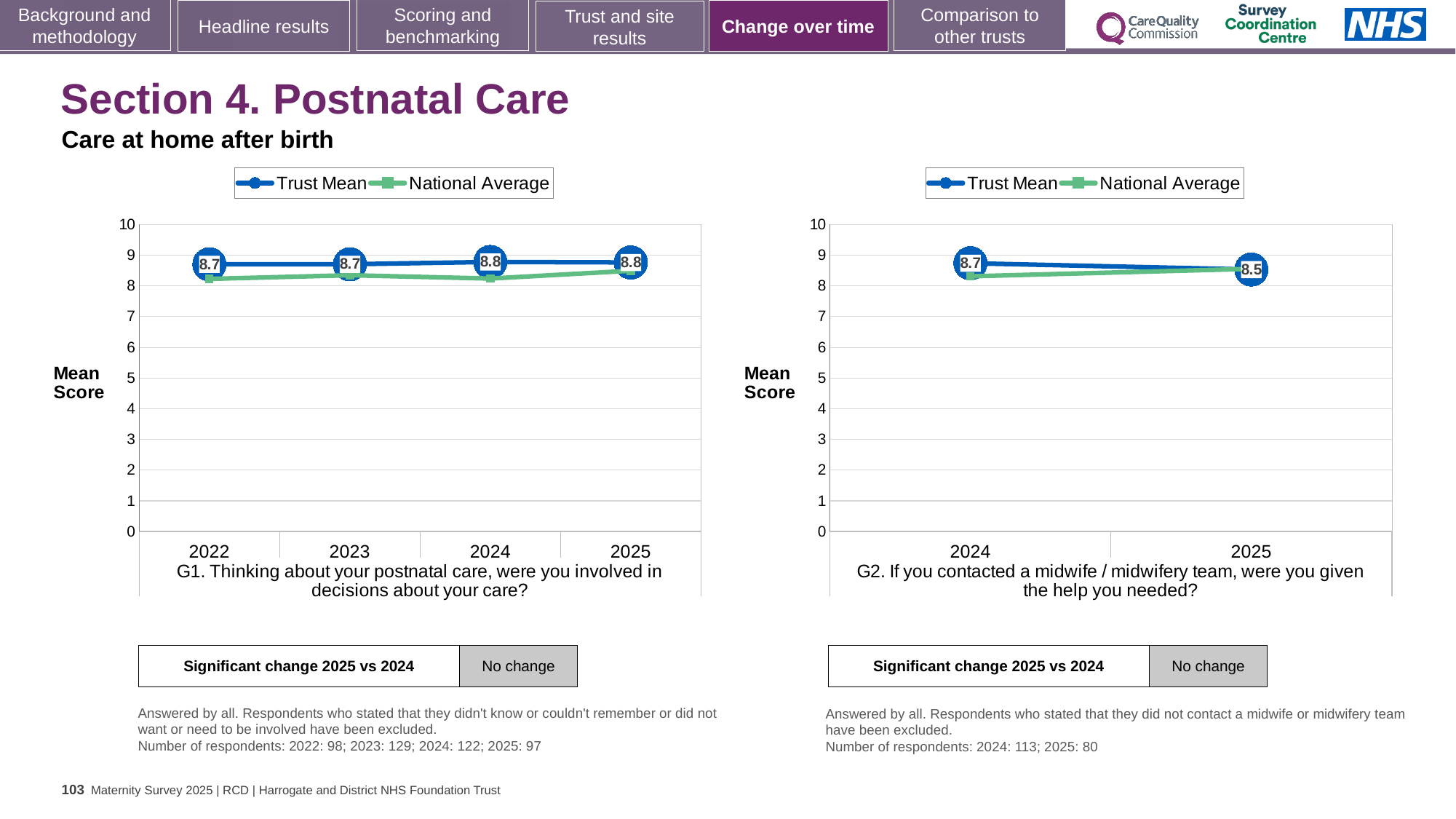
In the G2 chart on the right, what is the difference between the Trust Mean for 2024 and 2025? 0.2 In the G1 chart on the left, what is the Trust Mean for 2022? 8.7 In the G2 chart on the right, what is the Trust Mean for 2025? 8.5 In the G2 chart on the right, what is the Trust Mean for 2024? 8.7 In the G1 chart on the left, is the National Average for 2022 greater or less than 9? less In the G1 chart on the left, how many years are plotted on the x axis? 4 What does the box below the G2 chart on the right say about the significant change 2025 vs 2024? No change How many series does the legend of the G1 chart on the left list? 2 What kind of chart is the G1 chart on the left? Line chart In the G2 chart on the right, how many years are plotted on the x axis? 2 In the G1 chart on the left, what is the Trust Mean for 2025? 8.8 In the G2 chart on the right, does the Trust Mean rise or fall from 2024 to 2025? Fall